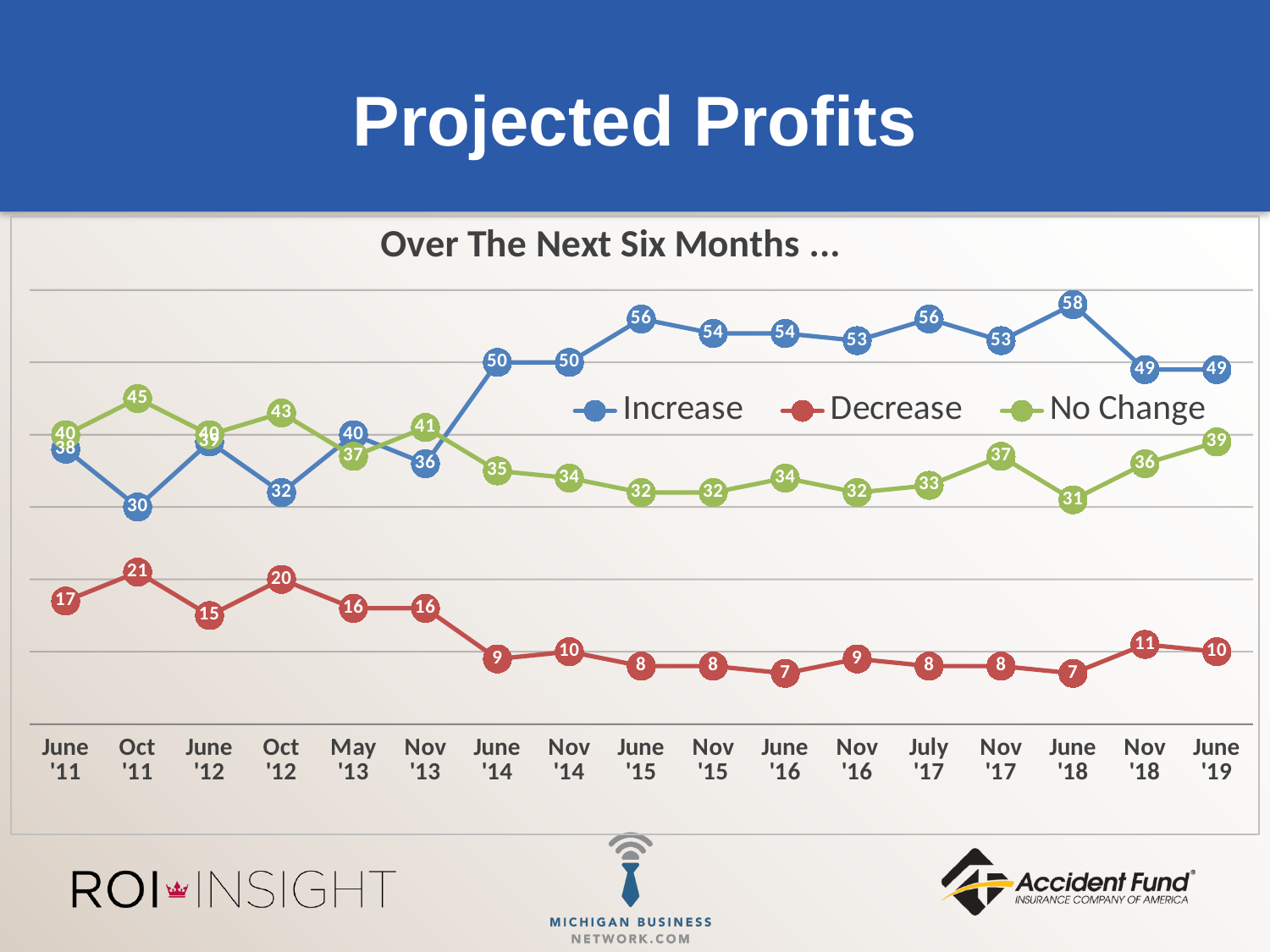
What is the title of the chart? Over The Next Six Months ... What is the value of the No Change series at June '19? 39 At which time point does the Increase series reach its highest value? June '18 At Oct '12, which is larger: Increase or No Change? No Change What type of chart is shown on the slide? line chart How many time points are shown on the x axis? 17 What is the lowest value reached by the Decrease series? 7 How many series does the legend list? 3 What is the value of the Decrease series at Oct '11? 21 What is the value of the Increase series at June '18? 58 At June '19, what is the difference between the Increase value and the No Change value? 10 Does the Decrease series overall rise or fall from June '11 to June '19? fall